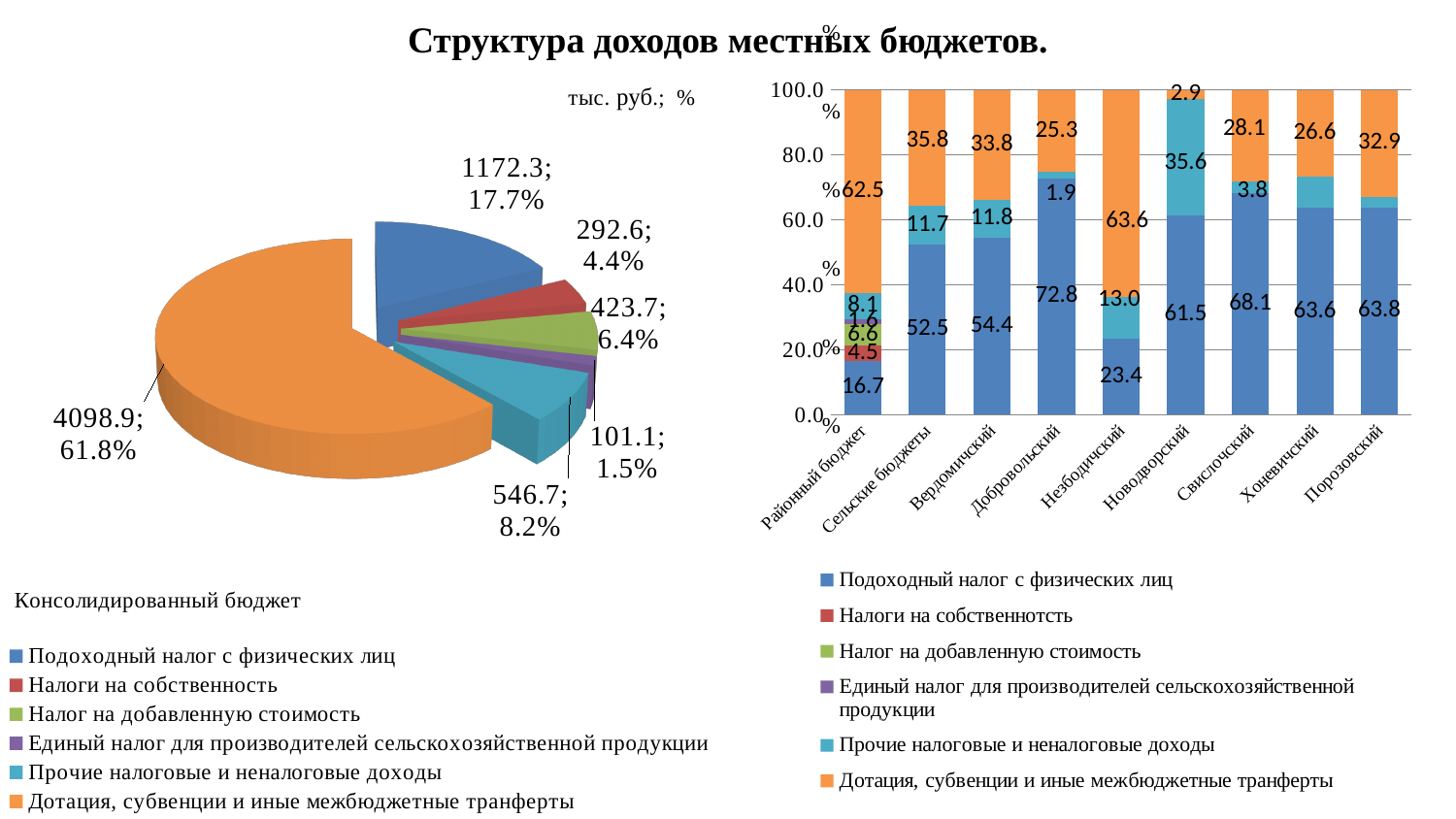
In the bar chart on the right, what is the value of Дотация, субвенции и иные межбюджетные трансферты for Незбодичский? 63.6 In the pie chart on the left, which category has the smallest slice? Единый налог для производителей сельскохозяйственной продукции In the pie chart on the left, which category has the largest slice? Дотация, субвенции и иные межбюджетные трансферты In the bar chart on the right, how many budget categories are shown on the x axis? 9 In the bar chart on the right, what is the value of Подоходный налог с физических лиц for Добровольский? 72.8 In the pie chart on the left, what value is shown for Дотация, субвенции и иные межбюджетные трансферты? 4098.9; 61.8% In the pie chart on the left, what share does Подоходный налог с физических лиц have? 17.7% In the bar chart on the right, how many series does the legend list? 6 In the bar chart on the right, what is the difference between the Дотация values for Сельские бюджеты and Вердомичский? 2.0 In the bar chart on the right, which budget has the highest value for Подоходный налог с физических лиц? Добровольский What kind of chart is the chart on the right? Stacked bar chart What kind of chart is the chart on the left? Pie chart